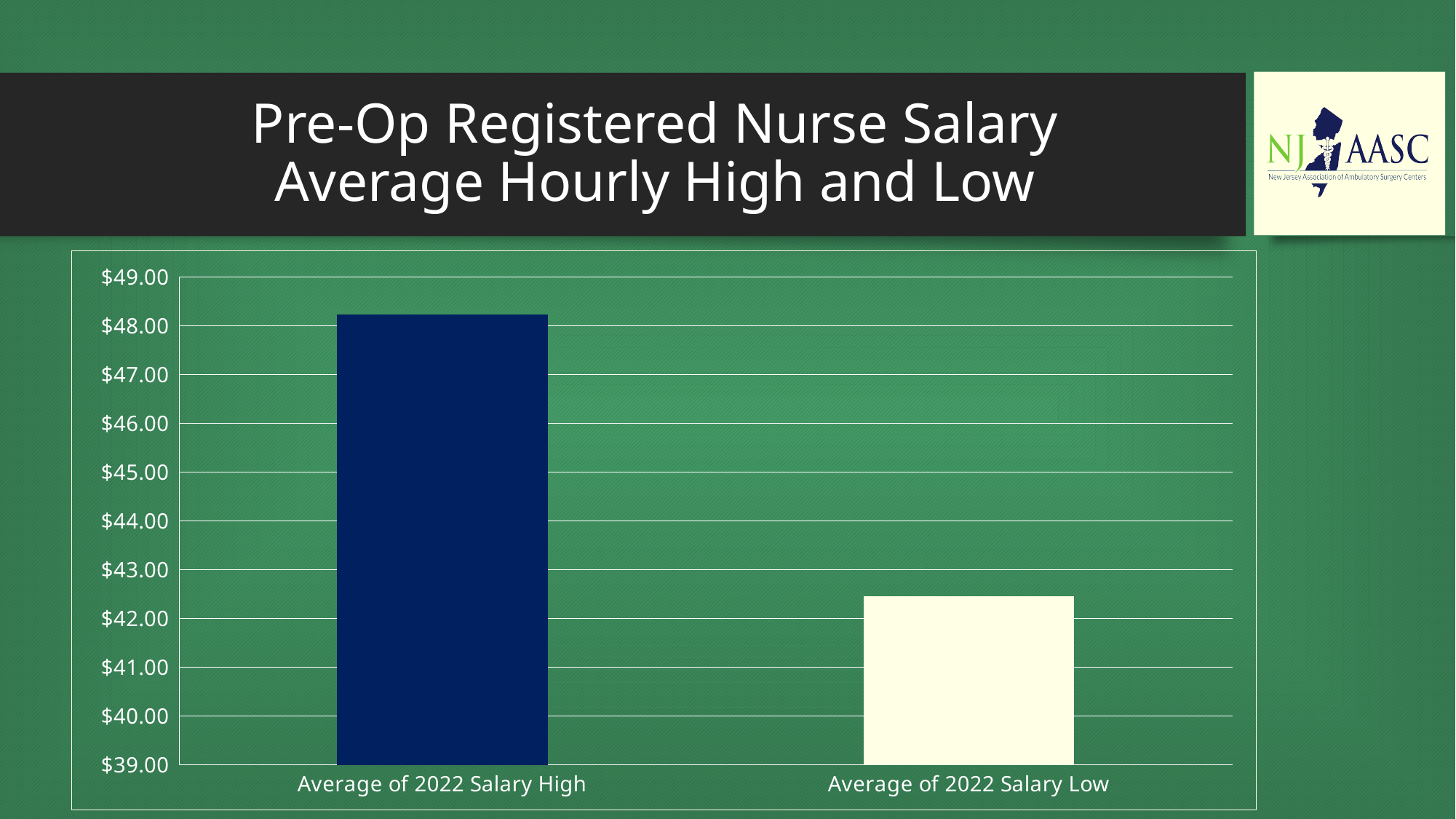
Is the value for Average of 2022 Salary High greater or less than $49.00? less Is the value for Average of 2022 Salary Low greater or less than $43.00? less Is the value for Average of 2022 Salary High greater or less than $48.00? greater Which category has the highest value? Average of 2022 Salary High What kind of chart is shown on the slide? bar chart How many bars are plotted in the chart? 2 What is the title of the chart on the slide? Pre-Op Registered Nurse Salary Average Hourly High and Low What is the lowest value shown on the vertical axis? $39.00 Which category has the lowest value? Average of 2022 Salary Low Which is larger, the value for Average of 2022 Salary High or Average of 2022 Salary Low? Average of 2022 Salary High